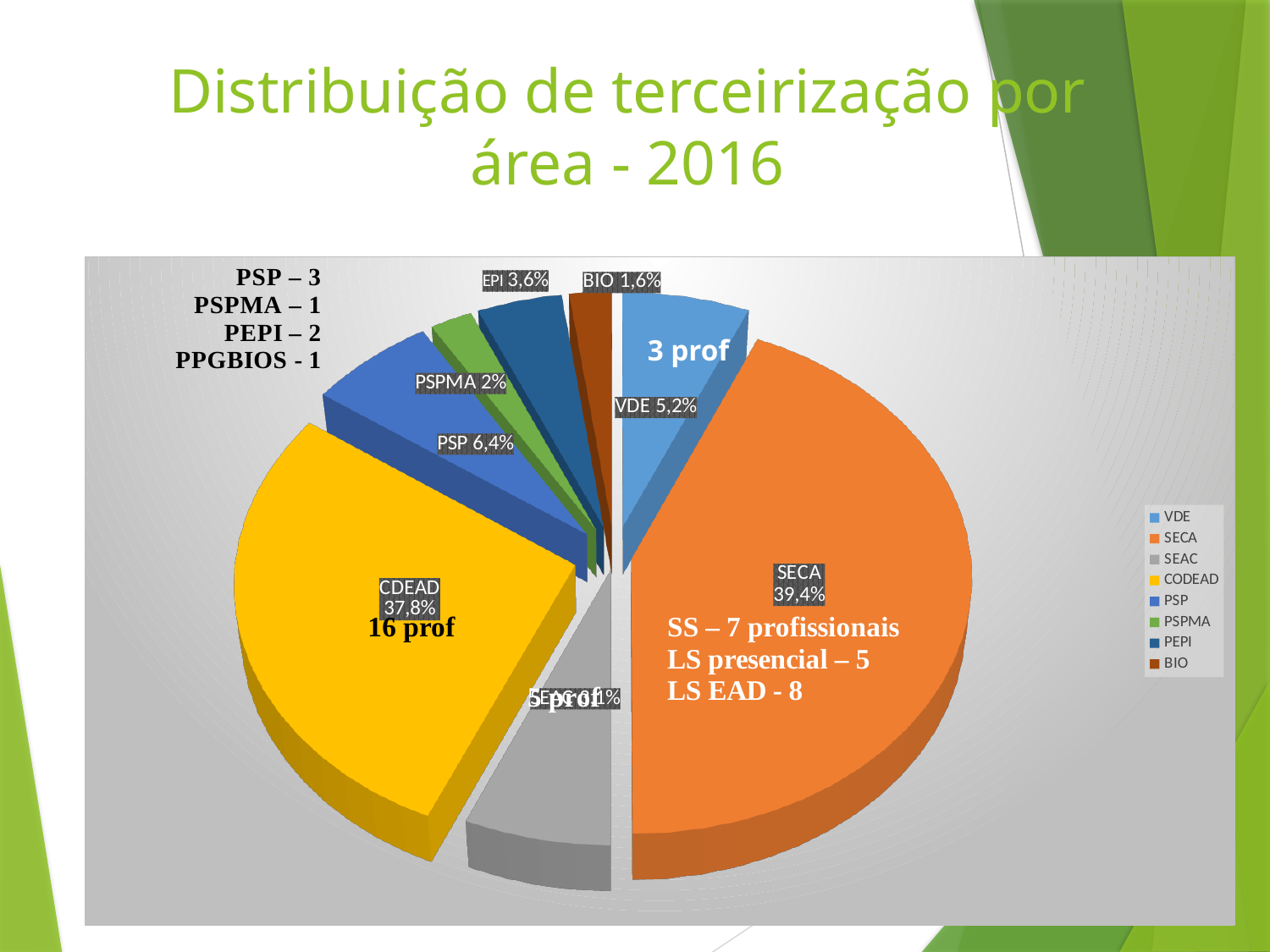
What percentage is shown for the BIO slice? 1,6% How many categories does the legend of the pie chart list? 8 What percentage is shown for the PSP slice? 6,4% What percentage is shown for the VDE slice? 5,2% What percentage is shown for the PSPMA slice? 2% Which slice is larger, SECA or CODEAD? SECA What percentage is shown for the SECA slice? 39,4% What type of chart is shown on the slide? pie chart What percentage is shown for the CODEAD slice? 37,8% Which category has the smallest share of the pie? BIO Which category has the largest share of the pie? SECA What is the title of the slide containing the pie chart? Distribuição de terceirização por área - 2016